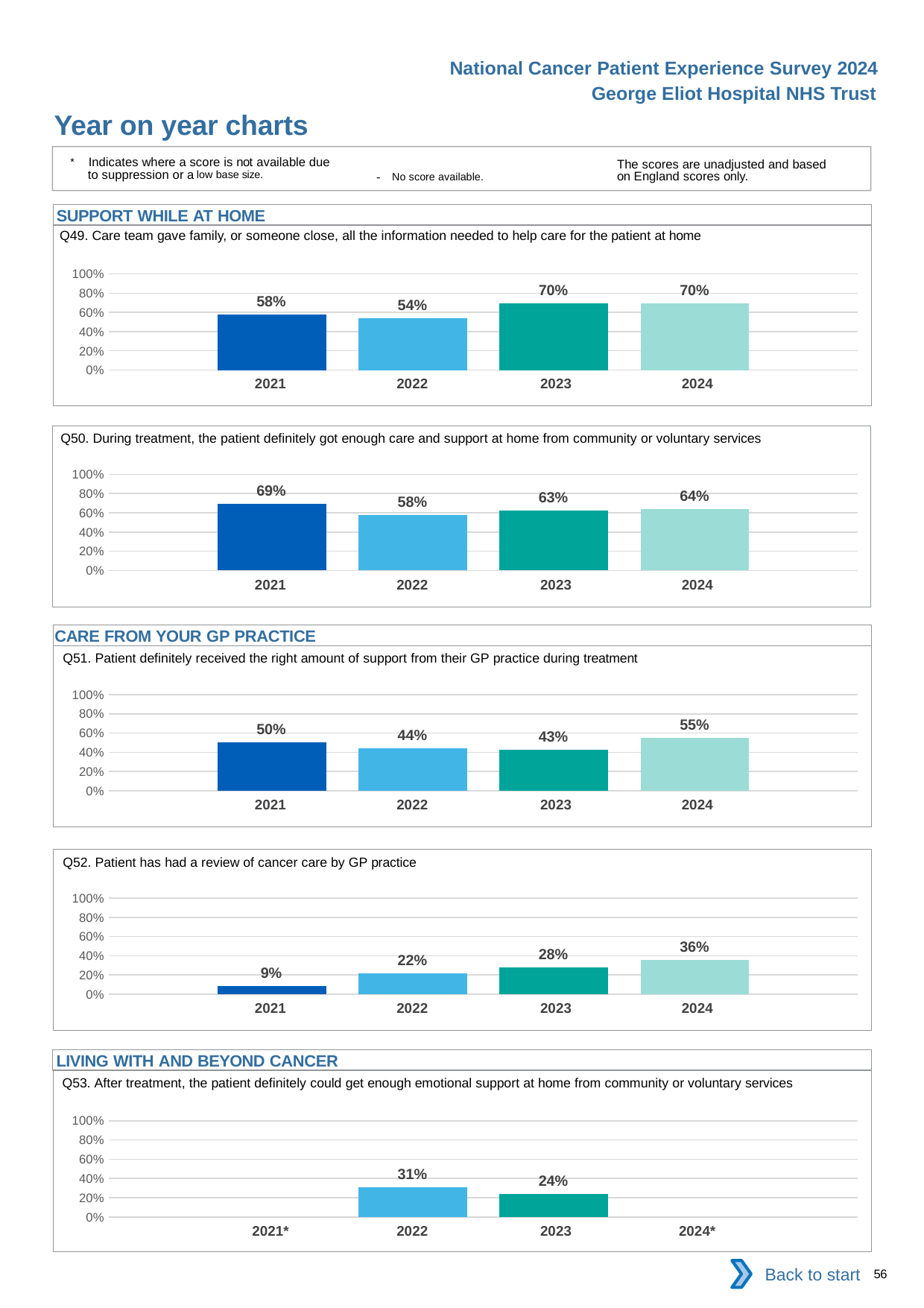
What kind of chart is used for Q49? Bar chart In the Q53 chart, how many years have a bar plotted? 2 In the Q52 chart, do the values rise or fall from 2021 to 2024? Rise In the Q53 chart, what is the value for 2022? 31% In the Q50 chart, what is the value for 2024? 64% In the Q51 chart, is the value for 2024 larger than the value for 2021? Yes In the Q49 chart, what is the difference between the 2024 value and the 2021 value? 12 percentage points In the Q52 chart, what is the difference between the 2024 value and the 2022 value? 14 percentage points In the Q52 chart, what is the value for 2021? 9% In the Q50 chart, which year has the highest value? 2021 In the Q51 chart, which year has the lowest value? 2023 In the Q49 chart, what is the value for 2022? 54%